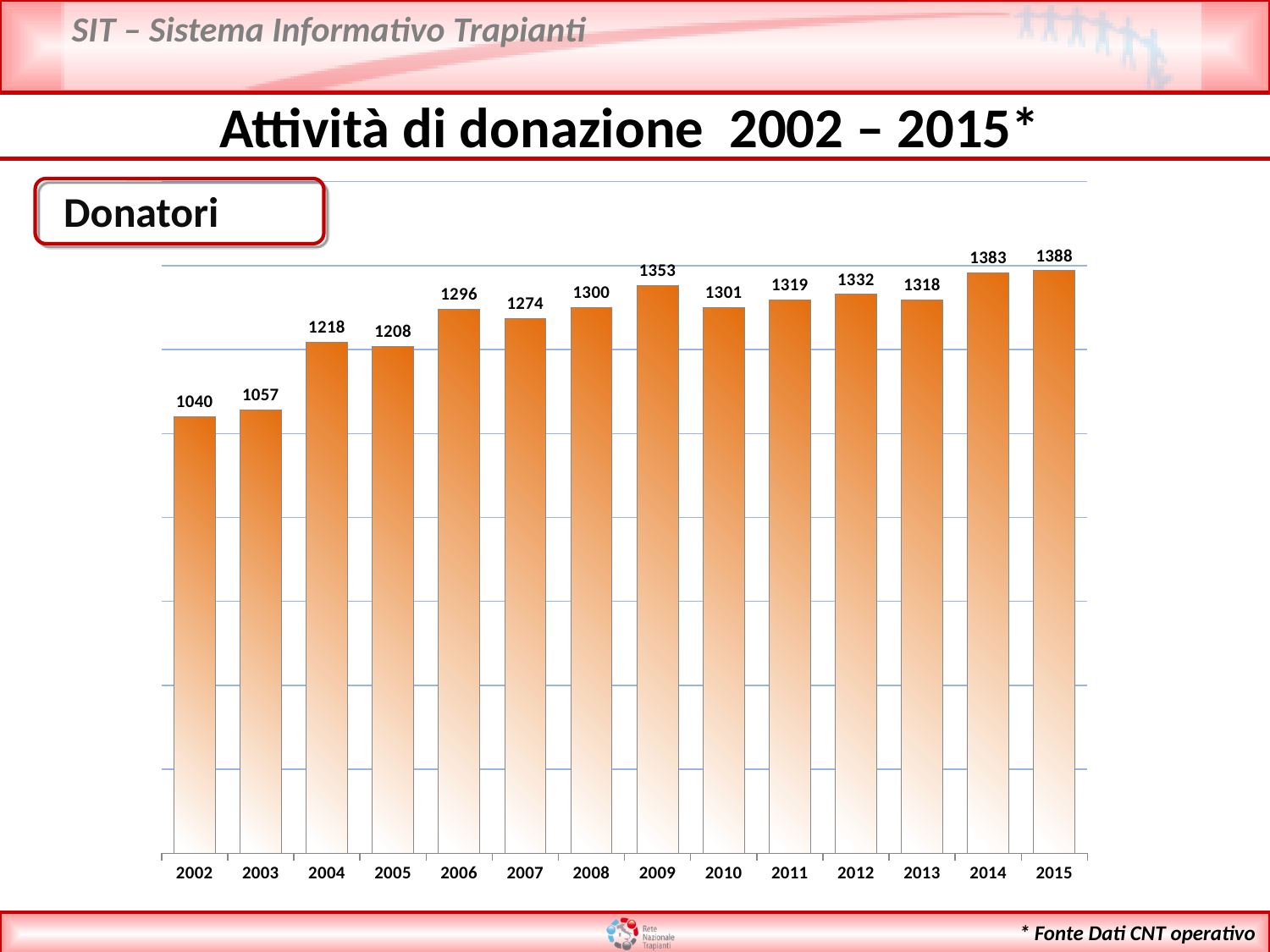
What is the difference between the values for 2015 and 2002? 348 What kind of chart is shown on the slide? bar chart Which year has the highest value? 2015 Which year has the lowest value? 2002 Which is larger, the value for 2006 or the value for 2007? 2006 What is the value for 2015? 1388 What is the value for 2009? 1353 What is the difference between the values for 2009 and 2010? 52 What is the label in the box above the chart? Donatori Which is larger, the value for 2004 or the value for 2005? 2004 How many years are shown on the x axis? 14 What is the value for 2002? 1040